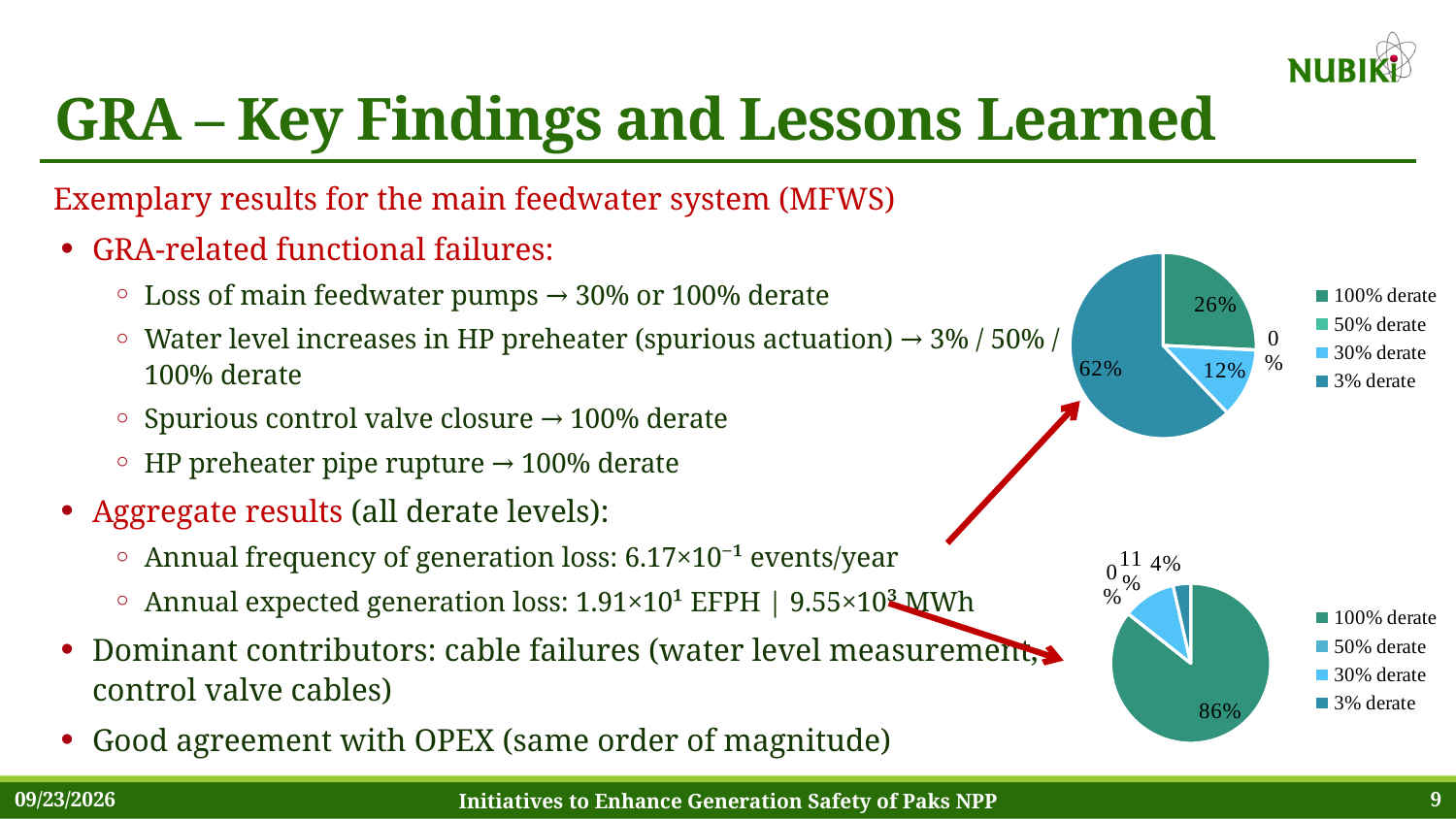
How many entries does the legend of the bottom pie chart list? 4 In the bottom pie chart, what share is labelled for the 30% derate slice? 11% What type of chart is the top chart on the right side of the slide? pie chart In the top pie chart, what share is labelled for the 30% derate slice? 12% In the top pie chart, what share is labelled for the 3% derate slice? 62% In the top pie chart, what share is labelled for the 100% derate slice? 26% In the bottom pie chart, what share is labelled for the 50% derate slice? 0% In the bottom pie chart, what share is labelled for the 100% derate slice? 86% In the top pie chart, which derate level has the largest share? 3% derate Which is larger in the top pie chart: the 100% derate share or the 30% derate share? 100% derate In the top pie chart, what is the difference between the 3% derate share and the 100% derate share? 36% In the bottom pie chart, which derate level has the largest share? 100% derate